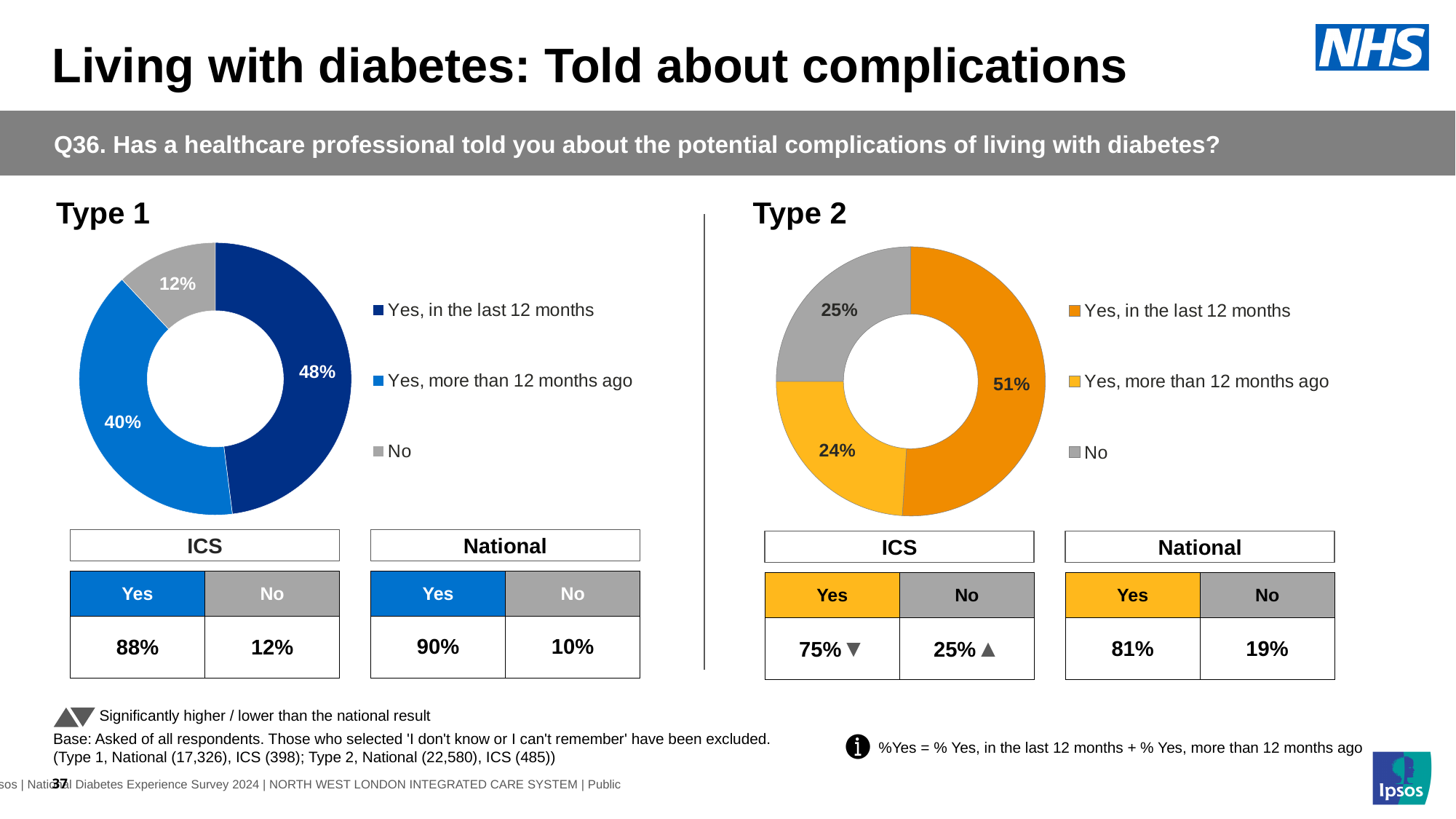
In the Type 2 chart, what is the difference between the 'Yes, in the last 12 months' share and the 'No' share? 26 percentage points How many categories does the Type 2 chart show? 3 In the Type 1 chart, what is the difference between the 'Yes, in the last 12 months' share and the 'Yes, more than 12 months ago' share? 8 percentage points Which is larger: the 'No' share in the Type 1 chart or the 'No' share in the Type 2 chart? Type 2 In the Type 2 chart, what percentage of respondents said 'Yes, more than 12 months ago'? 24% In the Type 2 chart, what percentage of respondents said 'No'? 25% In the Type 2 chart, which category has the smallest share? Yes, more than 12 months ago In the Type 1 chart, which category has the largest share? Yes, in the last 12 months In the Type 1 chart, what percentage of respondents said 'No'? 12% What colour represents 'No' in the Type 1 chart? Grey What kind of chart is used for Type 1? Doughnut (pie) chart In the Type 1 chart, what percentage of respondents said 'Yes, in the last 12 months'? 48%